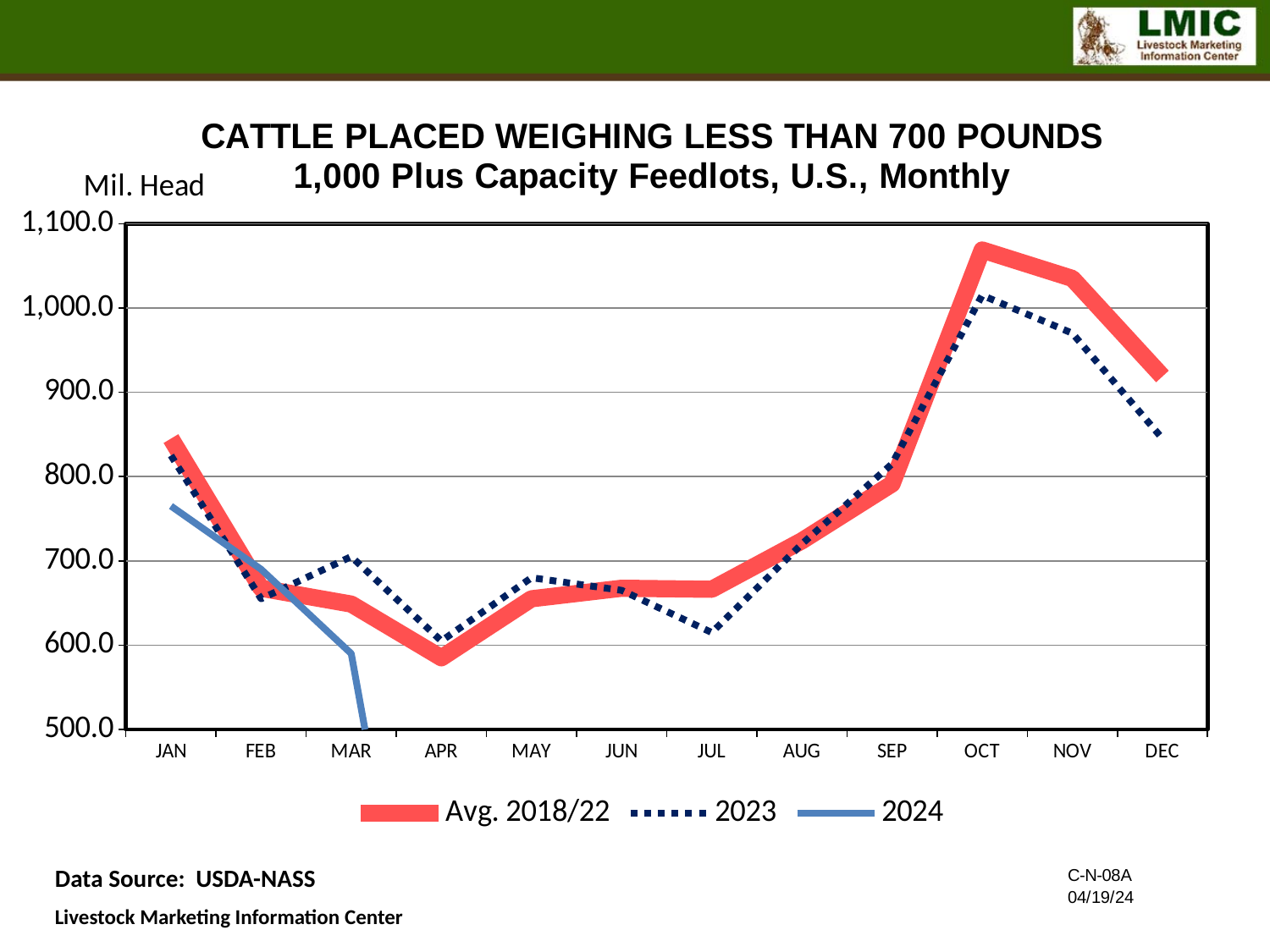
In which month does the Avg. 2018/22 series reach its highest value? OCT Is the 2023 value for DEC greater or less than 900.0? less How many months are shown on the x axis? 12 In which month does the Avg. 2018/22 series reach its lowest value? APR Is the 2024 value for MAR greater or less than 700.0? less In which month does the 2023 series reach its highest value? OCT What kind of chart is shown on the slide? line chart How many series does the legend list? 3 What unit label is shown above the y axis? Mil. Head Is the Avg. 2018/22 value for OCT greater or less than 1,000.0? greater Does the 2024 series rise or fall from JAN to MAR? fall In JAN, which series has the larger value, Avg. 2018/22 or 2024? Avg. 2018/22